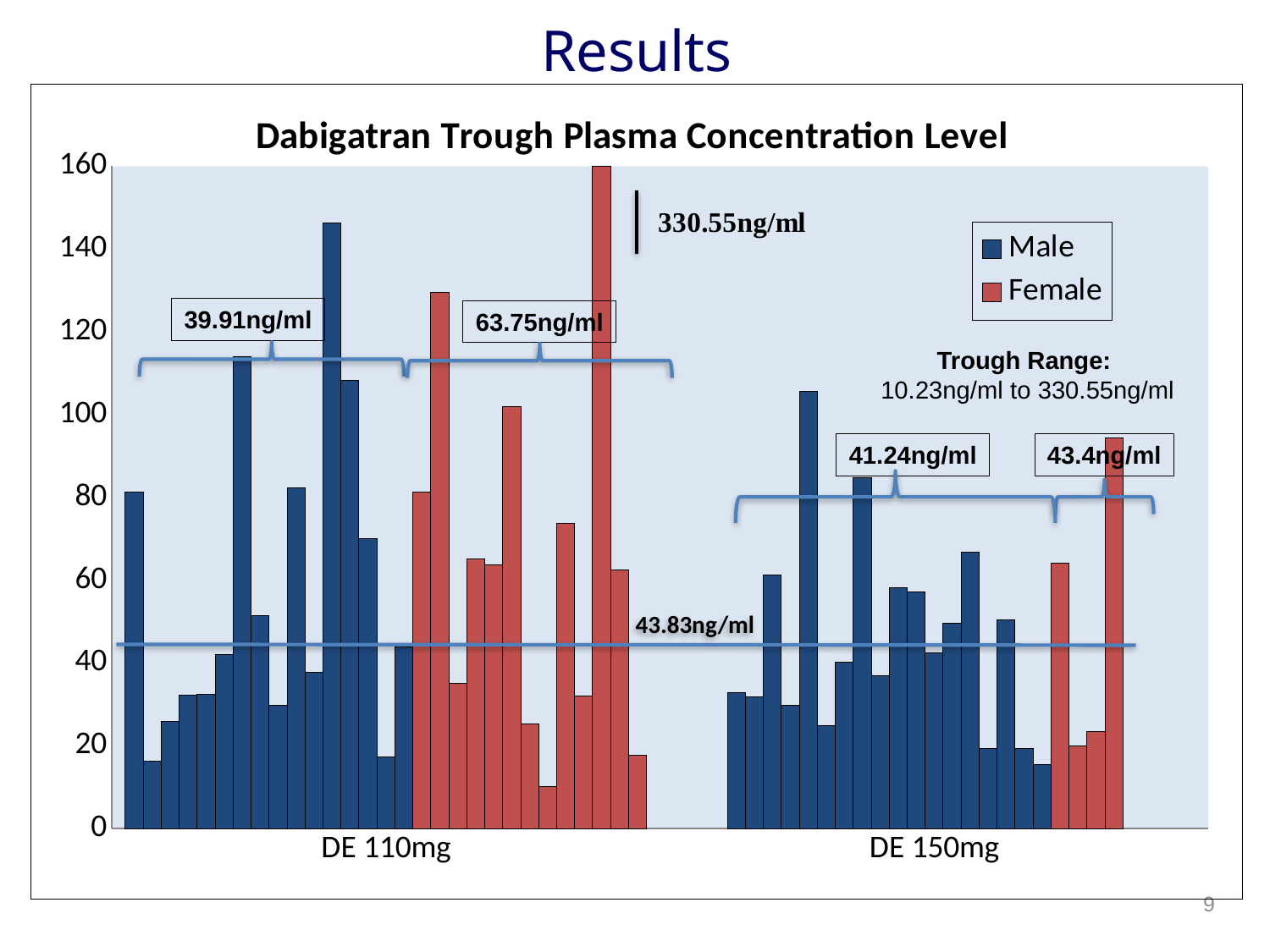
Is the tallest Male bar in the DE 110mg group greater or less than 140? greater What is the difference between the annotated Female and Male averages at DE 110mg (63.75ng/ml and 39.91ng/ml)? 23.84ng/ml How many dose groups are labelled on the x axis? 2 What average trough level is annotated for the Female group at DE 150mg? 43.4ng/ml What is the title of the chart? Dabigatran Trough Plasma Concentration Level How many series does the legend list? 2 What value is labelled on the horizontal line drawn across the chart? 43.83ng/ml What kind of chart is shown on the slide? bar chart What average trough level is annotated for the Male group at DE 110mg? 39.91ng/ml What average trough level is annotated for the Female group at DE 110mg? 63.75ng/ml What trough range is stated on the chart? 10.23ng/ml to 330.55ng/ml What are the two series named in the legend? Male and Female